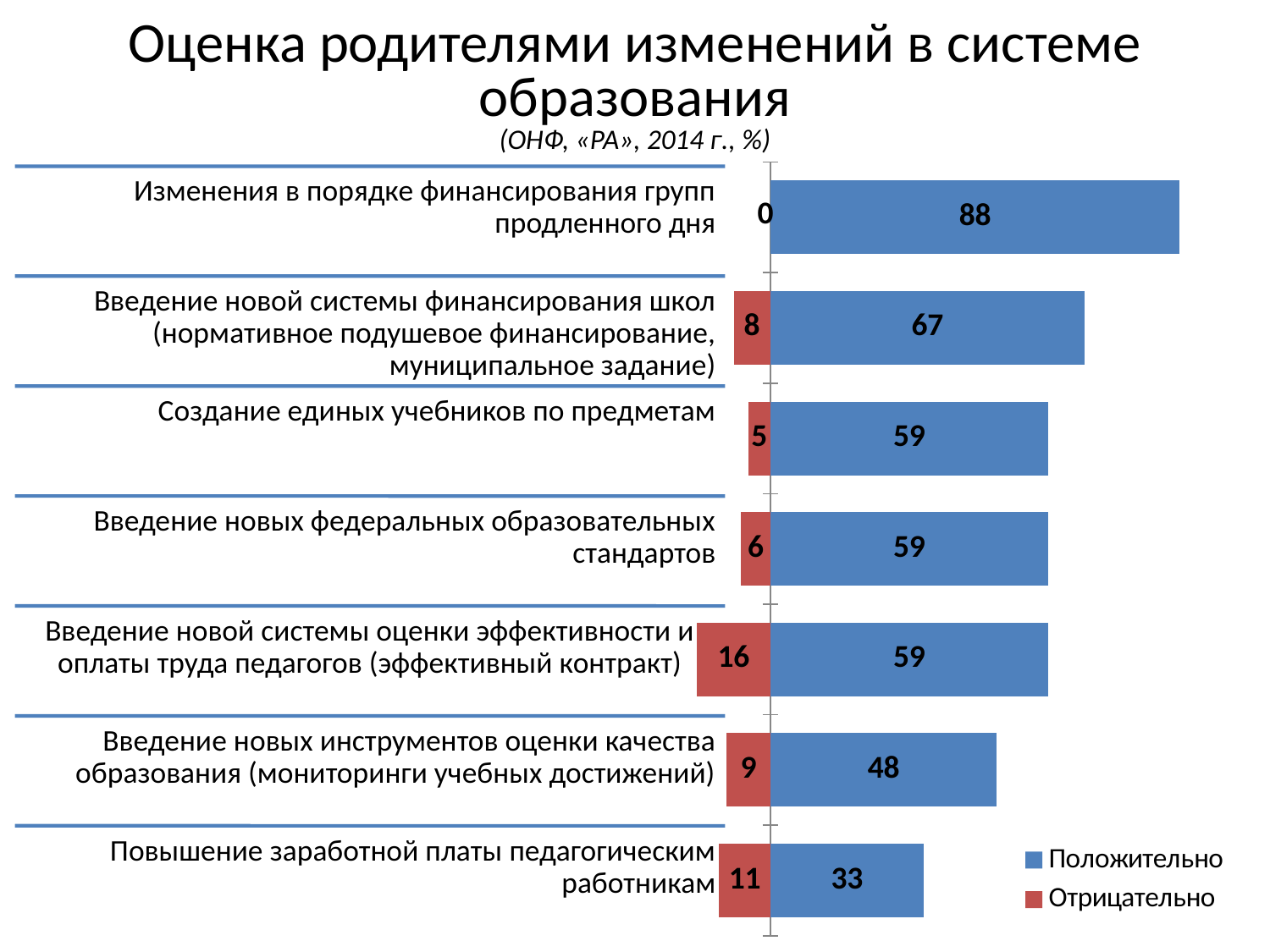
Which category has the highest 'Положительно' value? Изменения в порядке финансирования групп продленного дня What is the 'Отрицательно' value for 'Введение новой системы оценки эффективности и оплаты труда педагогов (эффективный контракт)'? 16 What is the 'Положительно' value for 'Изменения в порядке финансирования групп продленного дня'? 88 Which category has the lowest 'Положительно' value? Повышение заработной платы педагогическим работникам How many series does the legend list? 2 What is the difference between the 'Положительно' values for 'Введение новой системы финансирования школ' and 'Введение новых инструментов оценки качества образования'? 19 What is the 'Отрицательно' value for 'Создание единых учебников по предметам'? 5 Which category has the highest 'Отрицательно' value? Введение новой системы оценки эффективности и оплаты труда педагогов (эффективный контракт) Which is larger: the 'Отрицательно' value for 'Повышение заработной платы педагогическим работникам' or for 'Введение новых инструментов оценки качества образования'? Повышение заработной платы педагогическим работникам What is the 'Положительно' value for 'Повышение заработной платы педагогическим работникам'? 33 How many categories are shown in the chart? 7 What type of chart is shown on the slide? Bar chart